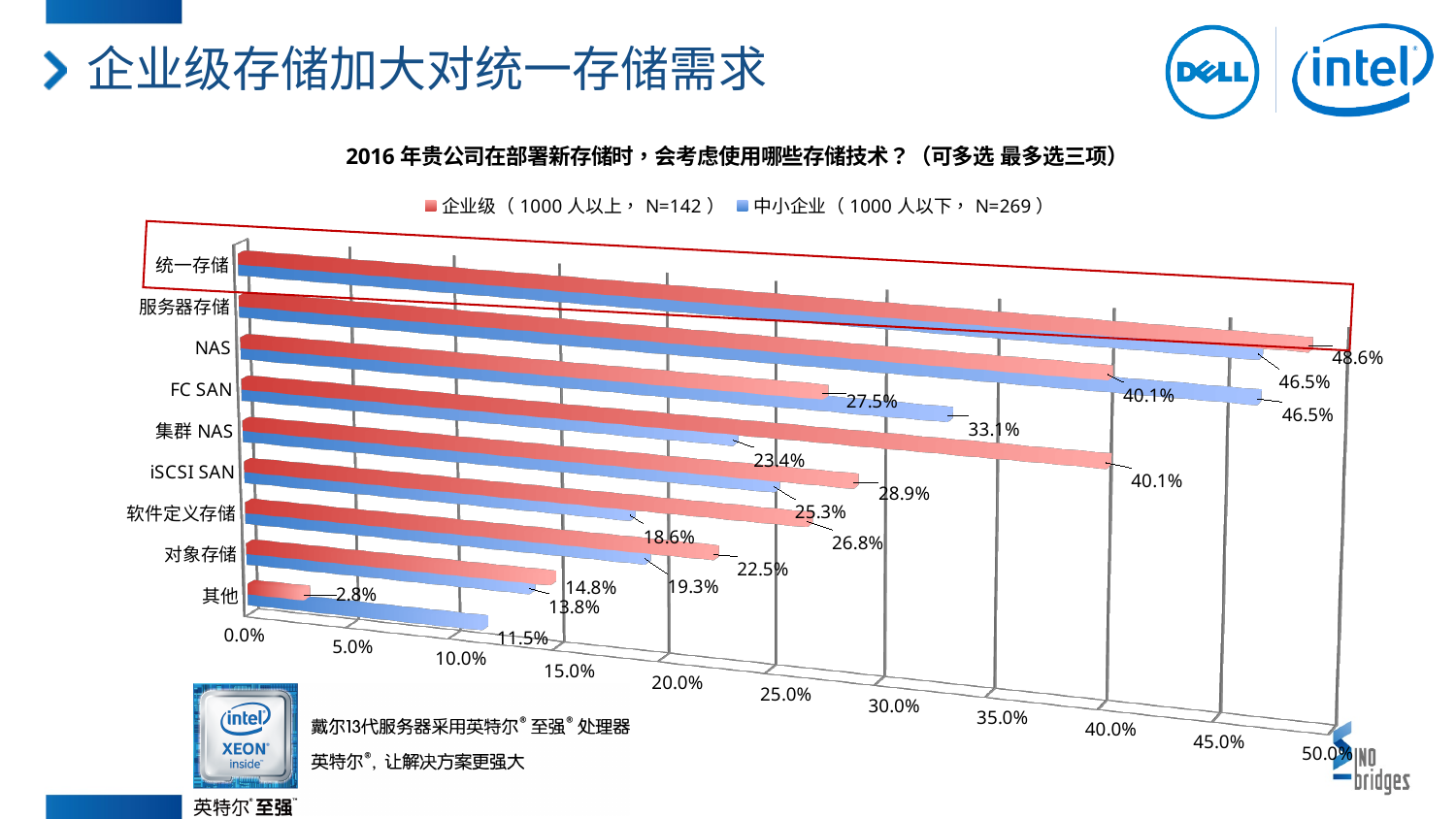
What is the 中小企业 (1000人以下) value for 其他? 11.5% For FC SAN, which group has the larger value, 企业级 or 中小企业? 企业级 What is the difference between the 企业级 and 中小企业 values for FC SAN? 16.7 percentage points What is the difference between the 企业级 and 中小企业 values for 统一存储? 2.1 percentage points For 服务器存储, which group has the larger value, 企业级 or 中小企业? 中小企业 What is the 中小企业 value for NAS? 33.1% How many storage technology categories are shown in the chart? 9 How many series does the legend list? 2 Which storage technology has the highest 企业级 value? 统一存储 What is the 企业级 (1000人以上) value for 统一存储? 48.6% Which storage technology has the lowest 企业级 value? 其他 What kind of chart is shown on the slide? Bar chart